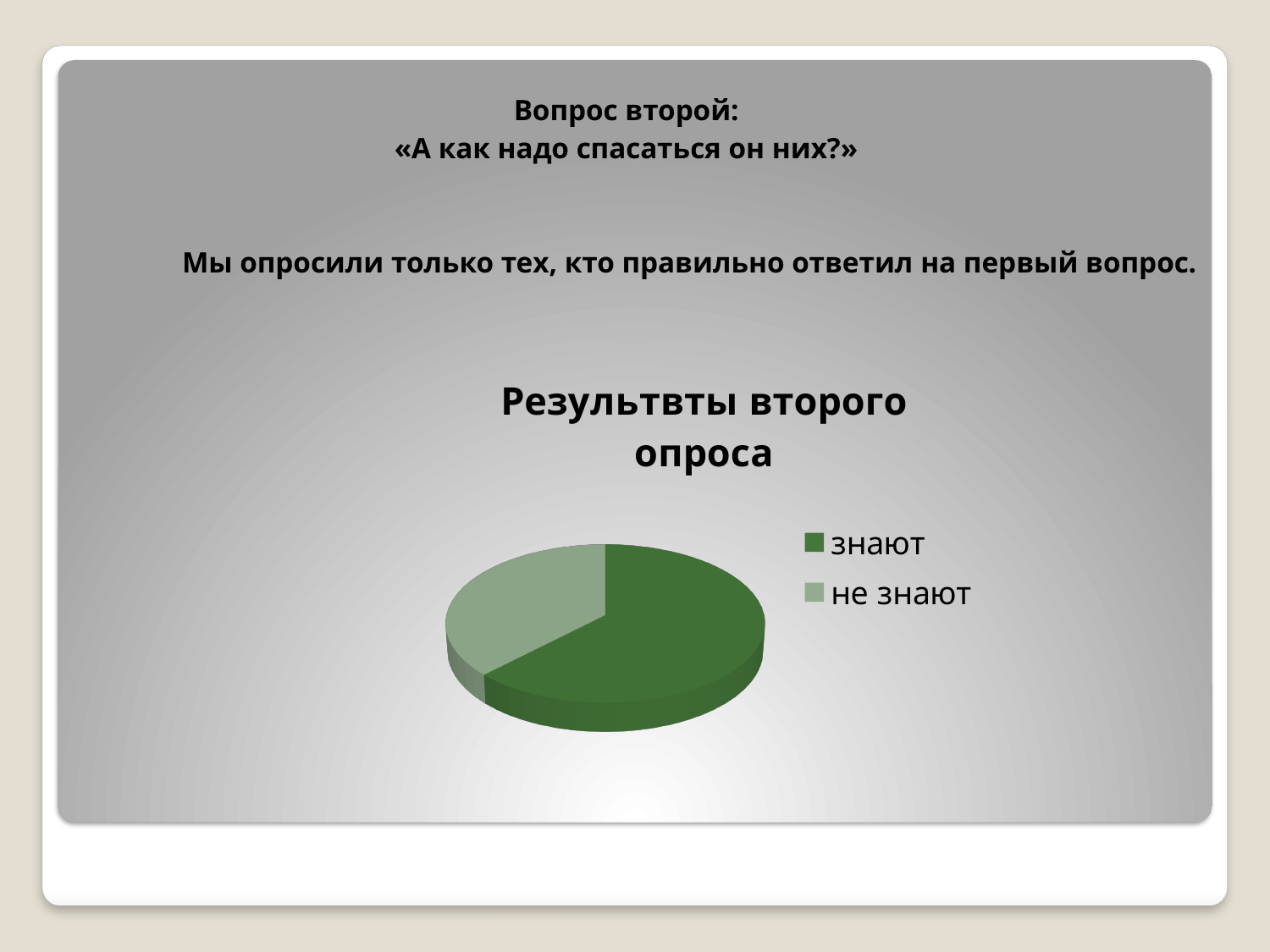
How many slices does the pie chart have? 2 Which slice is larger: знают or не знают? знают Which legend entry is shown in the darker green colour? знают What is the title of the chart? Результвты второго опроса How many entries does the chart legend list? 2 What kind of chart is shown on the slide? pie chart Which category has the largest slice of the pie? знают Which category has the smallest slice of the pie? не знают